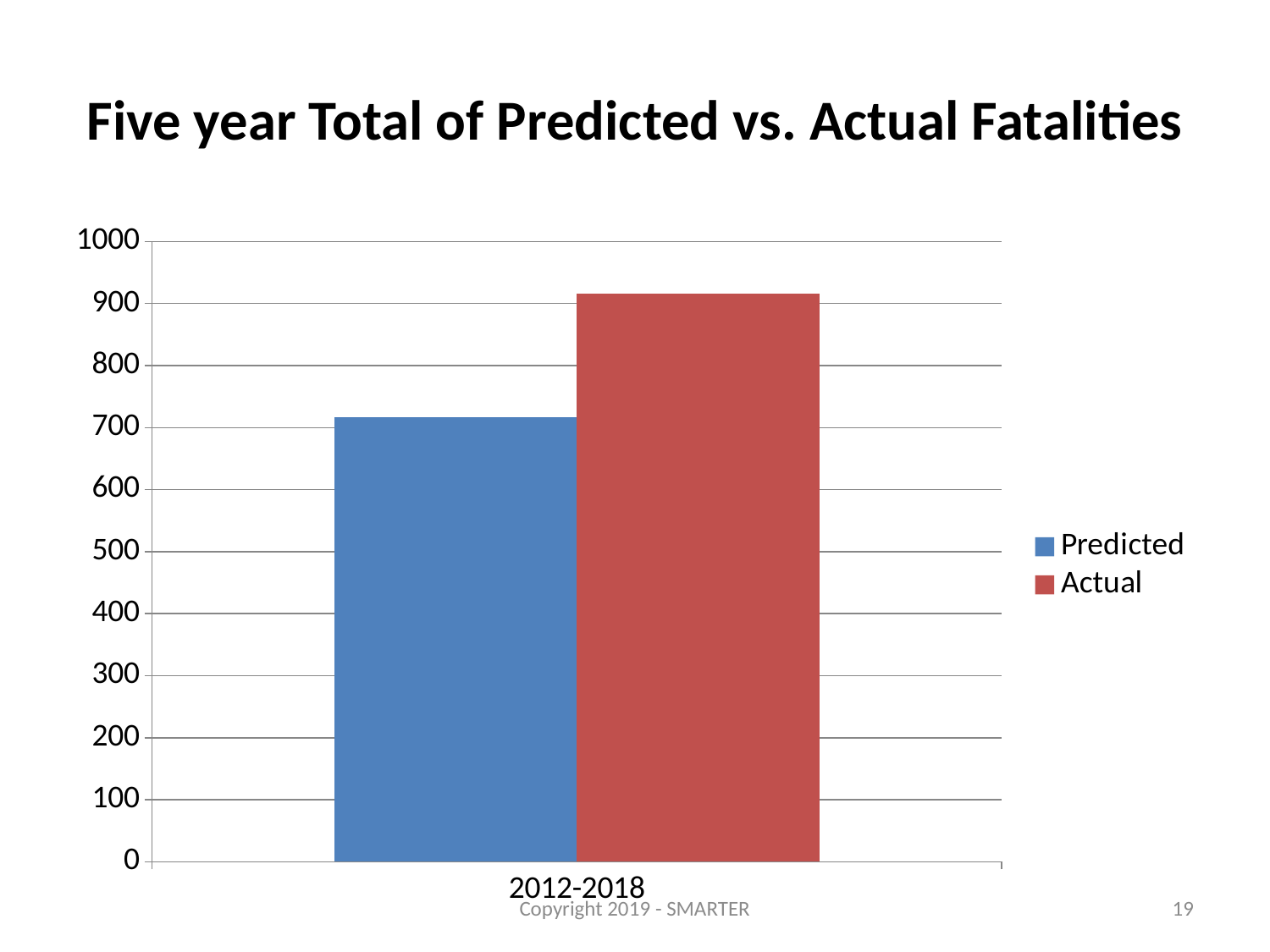
Is the value for Predicted greater or less than 600? greater Is the value for Actual greater or less than 1000? less How many categories are shown on the x axis? 1 What kind of chart is shown on the slide? bar chart What is the title of the chart? Five year Total of Predicted vs. Actual Fatalities Is the value for Predicted greater or less than 800? less Which series has the higher value for 2012-2018, Predicted or Actual? Actual How many series does the legend list? 2 Which series has the lowest value in the chart? Predicted What is the category label on the x axis? 2012-2018